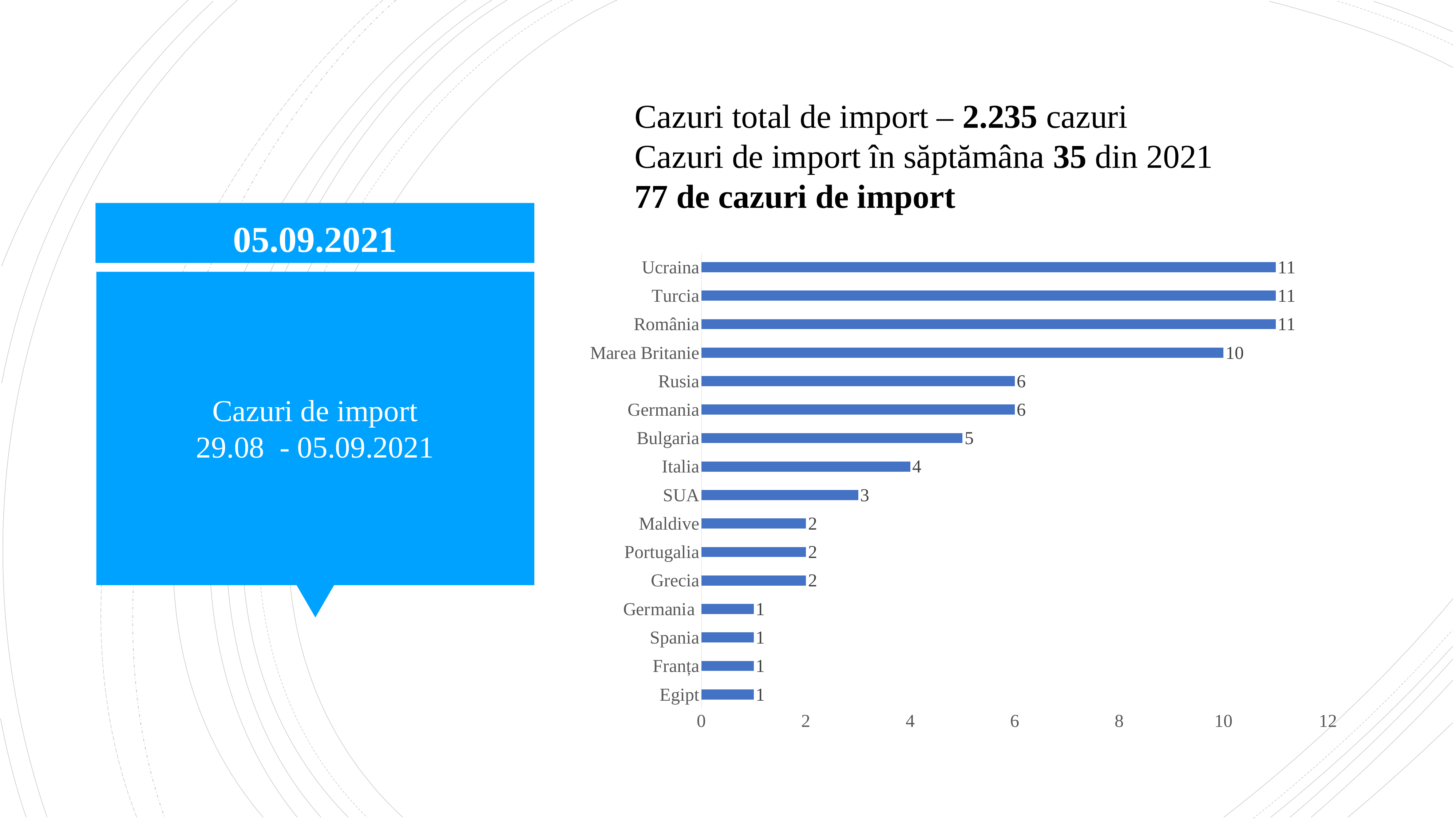
What is the value for Marea Britanie? 10 Which is larger, the value for Bulgaria or the value for Maldive? Bulgaria What is the difference between the values for Marea Britanie and Bulgaria? 5 What is the value for Italia? 4 How many categories are shown in the chart? 16 What is the value for SUA? 3 Is the value for Marea Britanie greater or less than 8? greater What is the value for Bulgaria? 5 What is the value for Ucraina? 11 What kind of chart is shown on the slide? bar chart What is the difference between the values for Ucraina and Rusia? 5 Which is larger, the value for Rusia or the value for Italia? Rusia